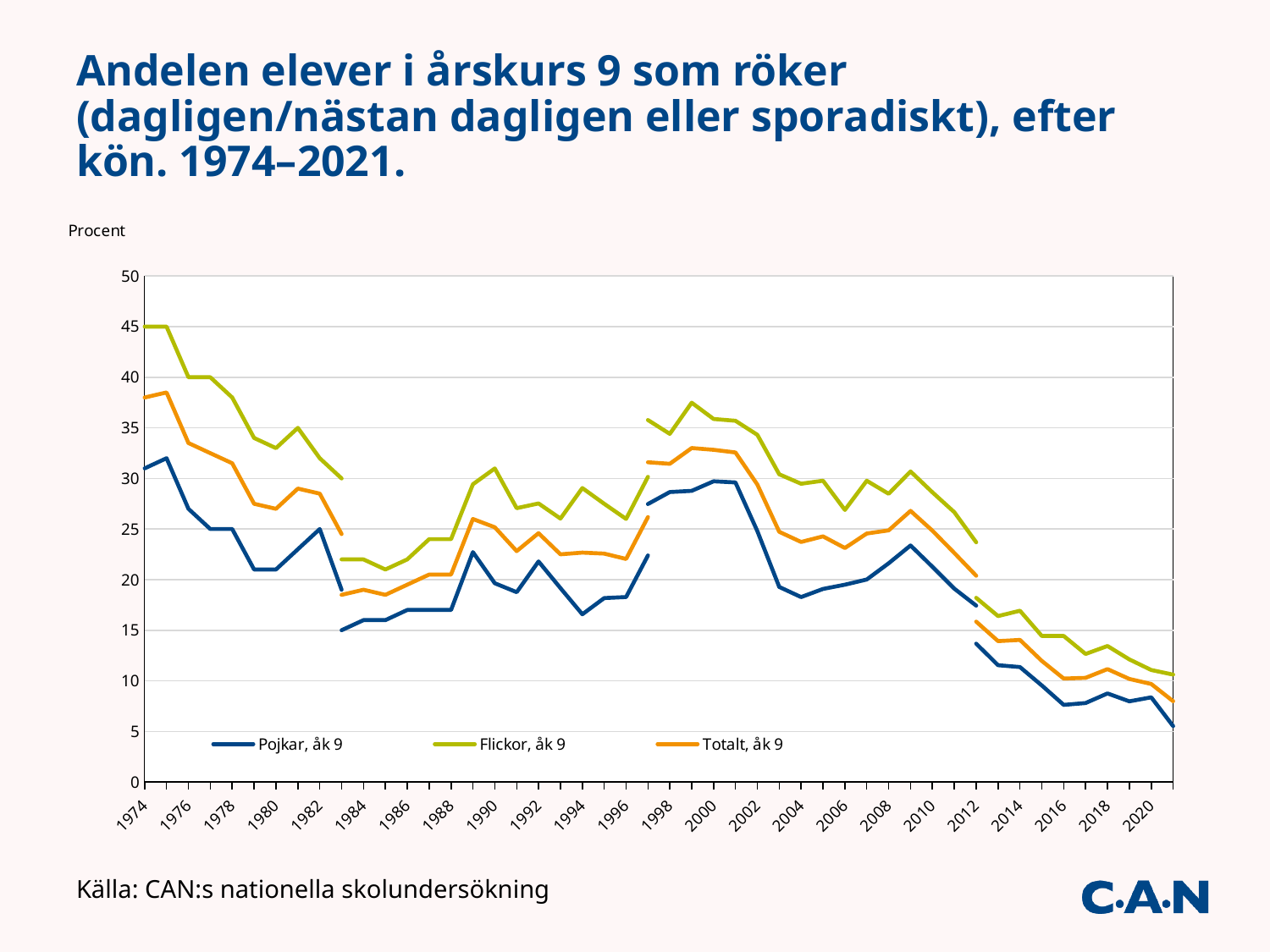
Which series is plotted with the green line? Flickor, åk 9 What is the label on the vertical axis? Procent In 1974, which series has the higher value, Pojkar, åk 9 or Flickor, åk 9? Flickor, åk 9 Overall, do the values for Pojkar, åk 9 rise or fall from 1974 to 2021? fall Is the value for Flickor, åk 9 in 1974 greater or less than 40? greater What kind of chart is shown on the slide? line chart Which series has the highest value in 2021? Flickor, åk 9 Is the value for Pojkar, åk 9 in 1974 greater or less than 25? greater How many series does the legend list? 3 Is the value for Pojkar, åk 9 in 2021 greater or less than 10? less